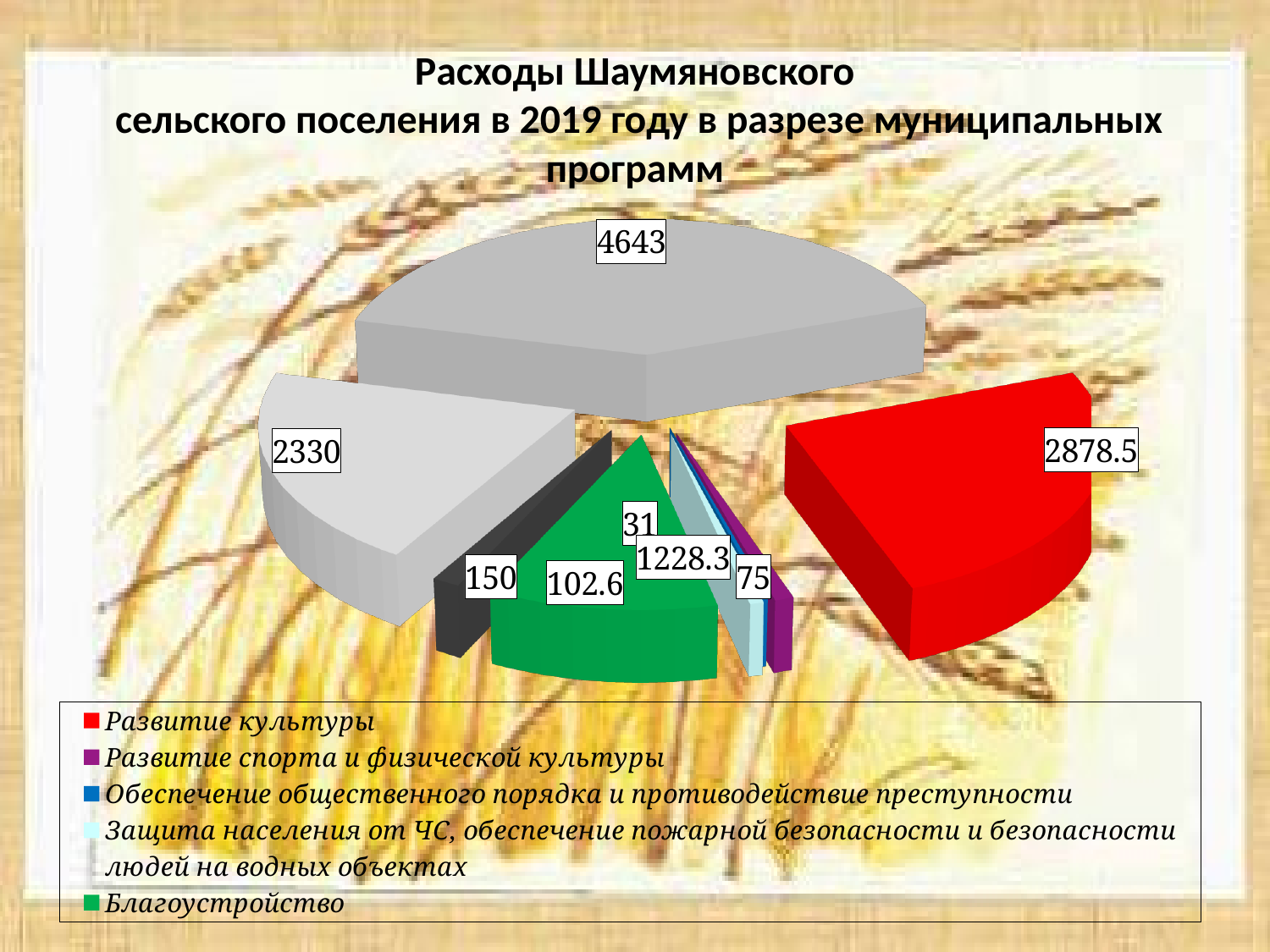
What colour represents Благоустройство in the legend? green What is the difference between the largest slice value (4643) and the value for Развитие культуры (2878.5)? 1764.5 How many entries does the legend list? 5 Which slice is larger: Развитие культуры or Благоустройство? Развитие культуры What is the value shown for Развитие культуры (the red slice)? 2878.5 What kind of chart is shown on the slide? pie chart Which year does the chart title say the expenditures refer to? 2019 What is the smallest value labelled on the pie chart? 31 How many data labels (slices) are shown on the pie chart? 8 What is the largest value labelled on the pie chart? 4643 Is the value for Развитие культуры greater or less than 2000? greater